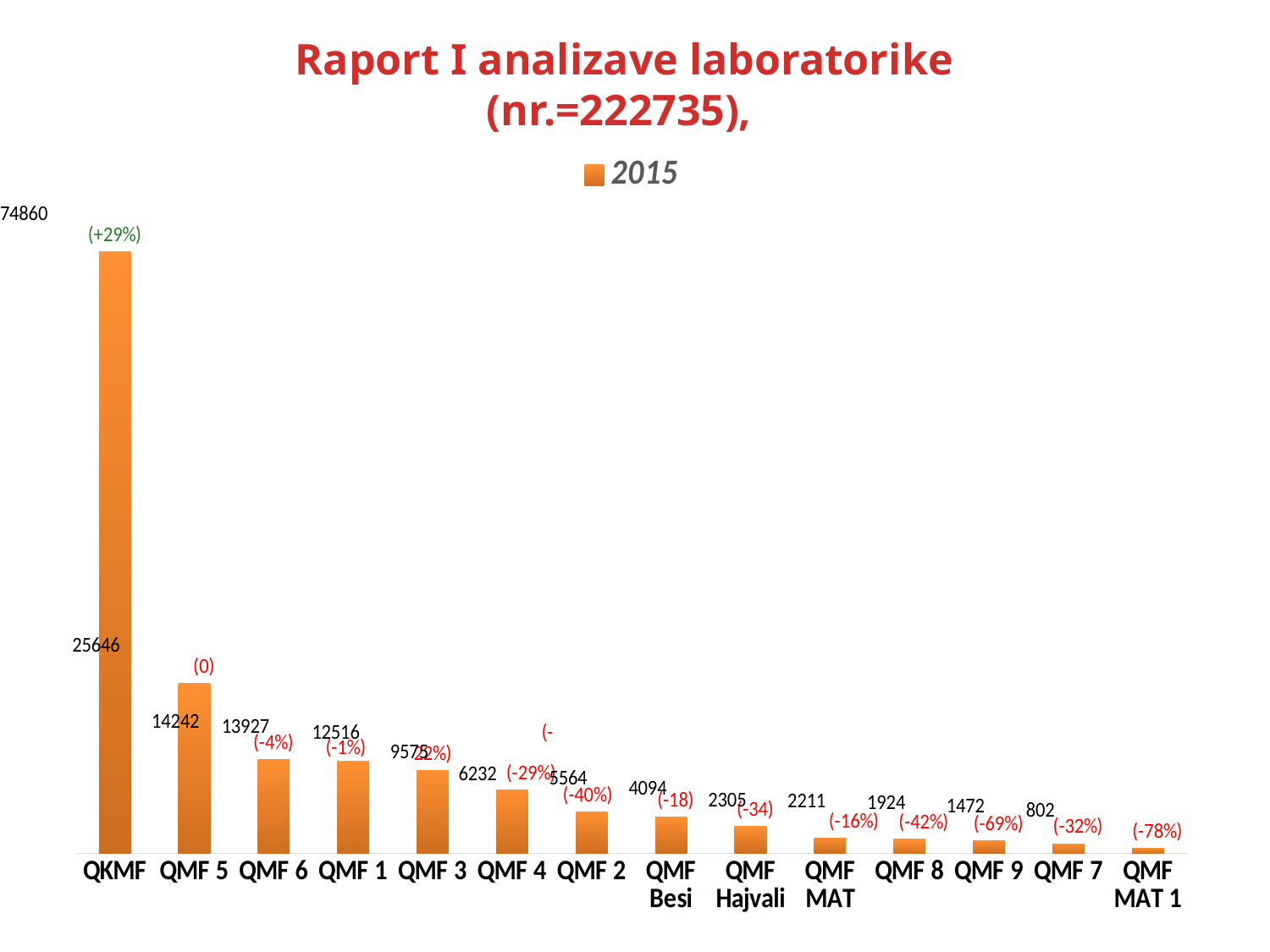
How many series does the legend list? 1 What is the difference between the values for QKMF and QMF MAT 1? 74058 Which category has the highest number of laboratory analyses? QKMF Which category has the lowest number of laboratory analyses? QMF MAT 1 What kind of chart is shown on the slide? bar chart What percentage change is printed above the QKMF bar? (+29%) What series name is shown in the legend? 2015 What percentage change is printed above the QMF MAT 1 bar? (-78%) What is the value shown for QKMF? 74860 How many categories (health centres) are shown on the x axis? 14 Which is larger, the value for QKMF or the value for QMF 5? QKMF What is the value shown for QMF MAT 1? 802